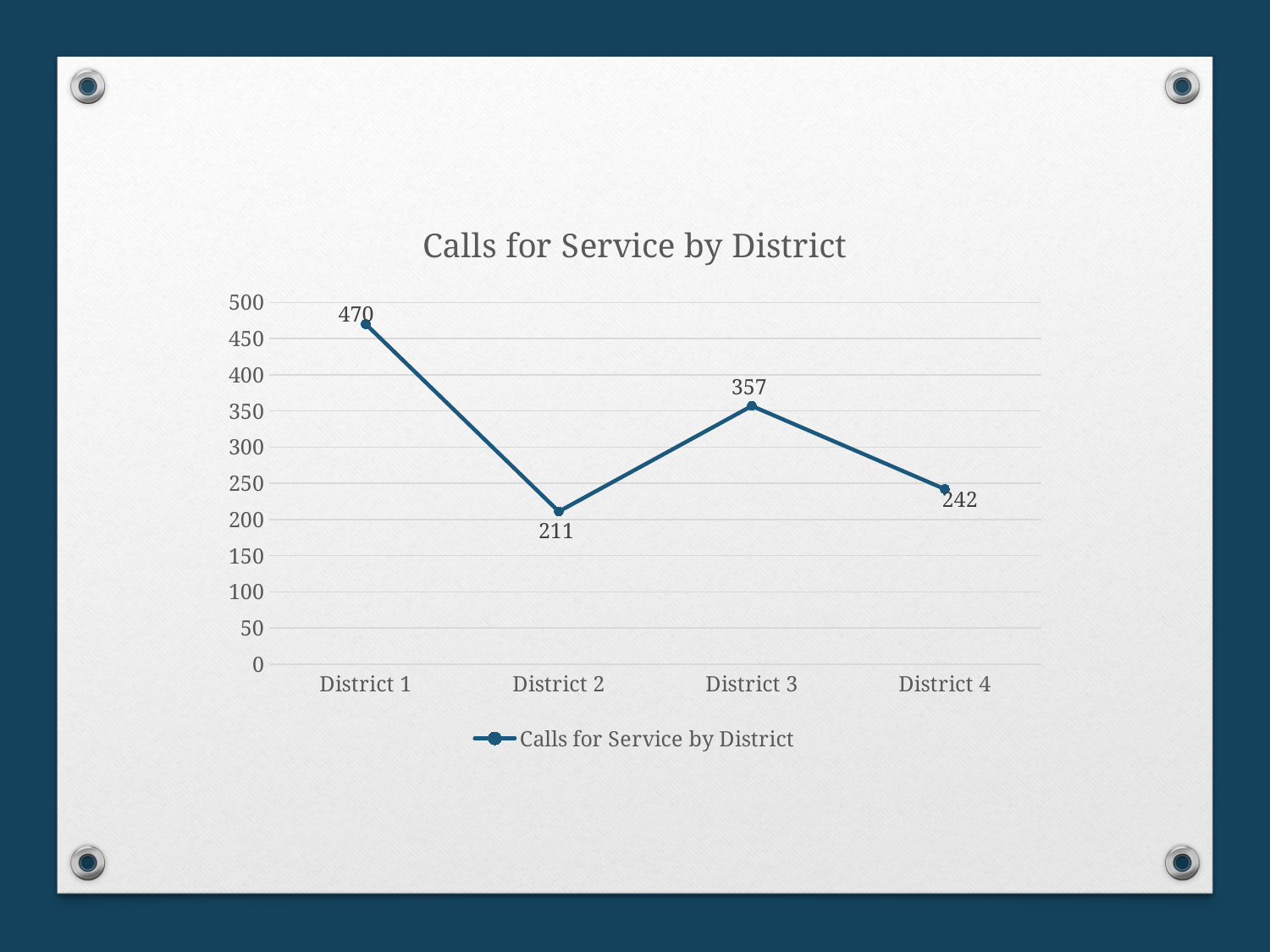
How many districts are plotted on the chart? 4 What kind of chart is shown on the slide? Line chart Which has a larger value, District 3 or District 4? District 3 What is the value for District 4? 242 Which district has the lowest number of calls for service? District 2 Which district has the highest number of calls for service? District 1 What is the value for District 2? 211 What is the difference between the values for District 1 and District 2? 259 What is the title of the chart? Calls for Service by District What is the value for District 1? 470 What is the difference between the values for District 3 and District 4? 115 What is the value for District 3? 357